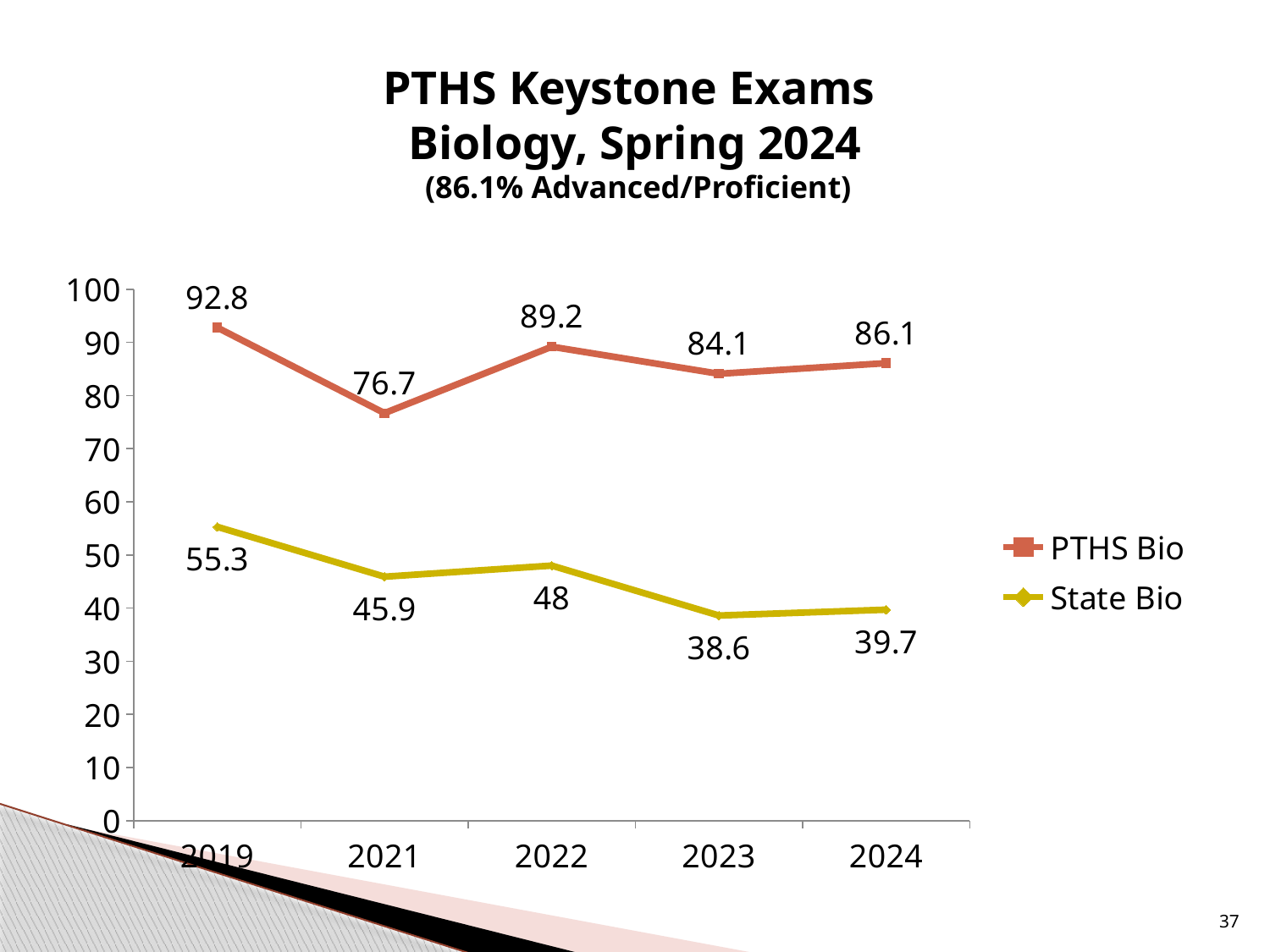
What is the difference between the PTHS Bio values for 2019 and 2021? 16.1 What is the State Bio value for 2023? 38.6 What is the difference between the PTHS Bio and State Bio values in 2024? 46.4 How many years are shown on the x axis? 5 What is the PTHS Bio value for 2019? 92.8 What is the PTHS Bio value for 2024? 86.1 Which is larger, the State Bio value for 2022 or for 2021? 2022 What kind of chart is shown on the slide? Line chart In which year is the PTHS Bio value lowest? 2021 How many series does the legend list? 2 In which year is the State Bio value highest? 2019 Does the State Bio series rise or fall from 2022 to 2023? Fall